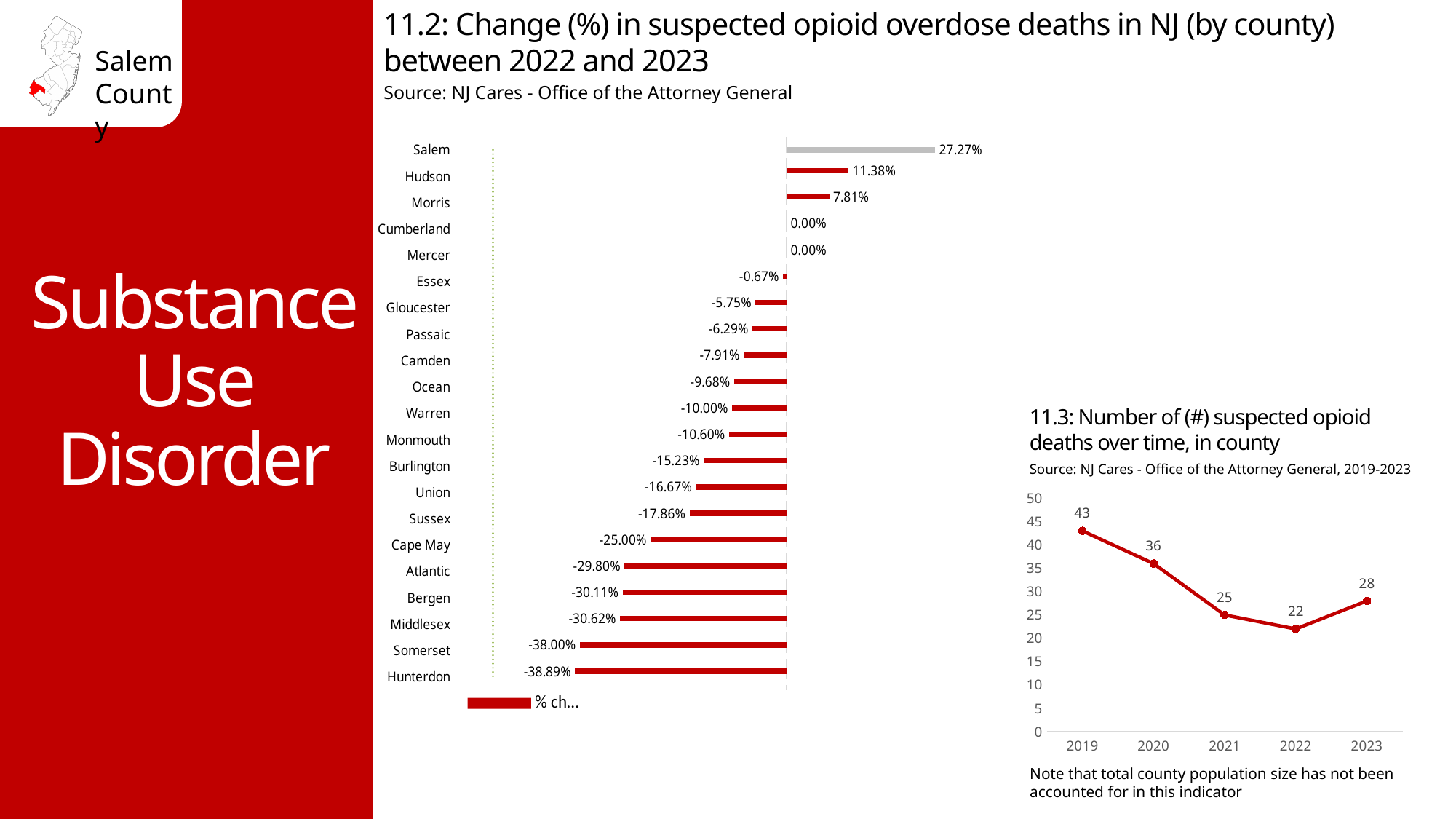
In the chart '11.3: Number of (#) suspected opioid deaths over time, in county', what is the value for 2019? 43 In the chart '11.2: Change (%) in suspected opioid overdose deaths in NJ (by county) between 2022 and 2023', how many counties are shown? 21 In the chart '11.2: Change (%) in suspected opioid overdose deaths in NJ (by county) between 2022 and 2023', what kind of chart is it? Bar chart In the chart '11.3: Number of (#) suspected opioid deaths over time, in county', what is the difference between the values for 2019 and 2023? 15 In the chart '11.3: Number of (#) suspected opioid deaths over time, in county', which year has the lowest value? 2022 In the chart '11.2: Change (%) in suspected opioid overdose deaths in NJ (by county) between 2022 and 2023', which is larger, the value for Hudson or the value for Morris? Hudson In the chart '11.2: Change (%) in suspected opioid overdose deaths in NJ (by county) between 2022 and 2023', what is the value for Hunterdon? -38.89% In the chart '11.2: Change (%) in suspected opioid overdose deaths in NJ (by county) between 2022 and 2023', what is the value for Salem? 27.27% In the chart '11.2: Change (%) in suspected opioid overdose deaths in NJ (by county) between 2022 and 2023', which county has the lowest value? Hunterdon In the chart '11.3: Number of (#) suspected opioid deaths over time, in county', what kind of chart is it? Line chart In the chart '11.3: Number of (#) suspected opioid deaths over time, in county', how many data points are plotted? 5 In the chart '11.2: Change (%) in suspected opioid overdose deaths in NJ (by county) between 2022 and 2023', which county has the highest value? Salem